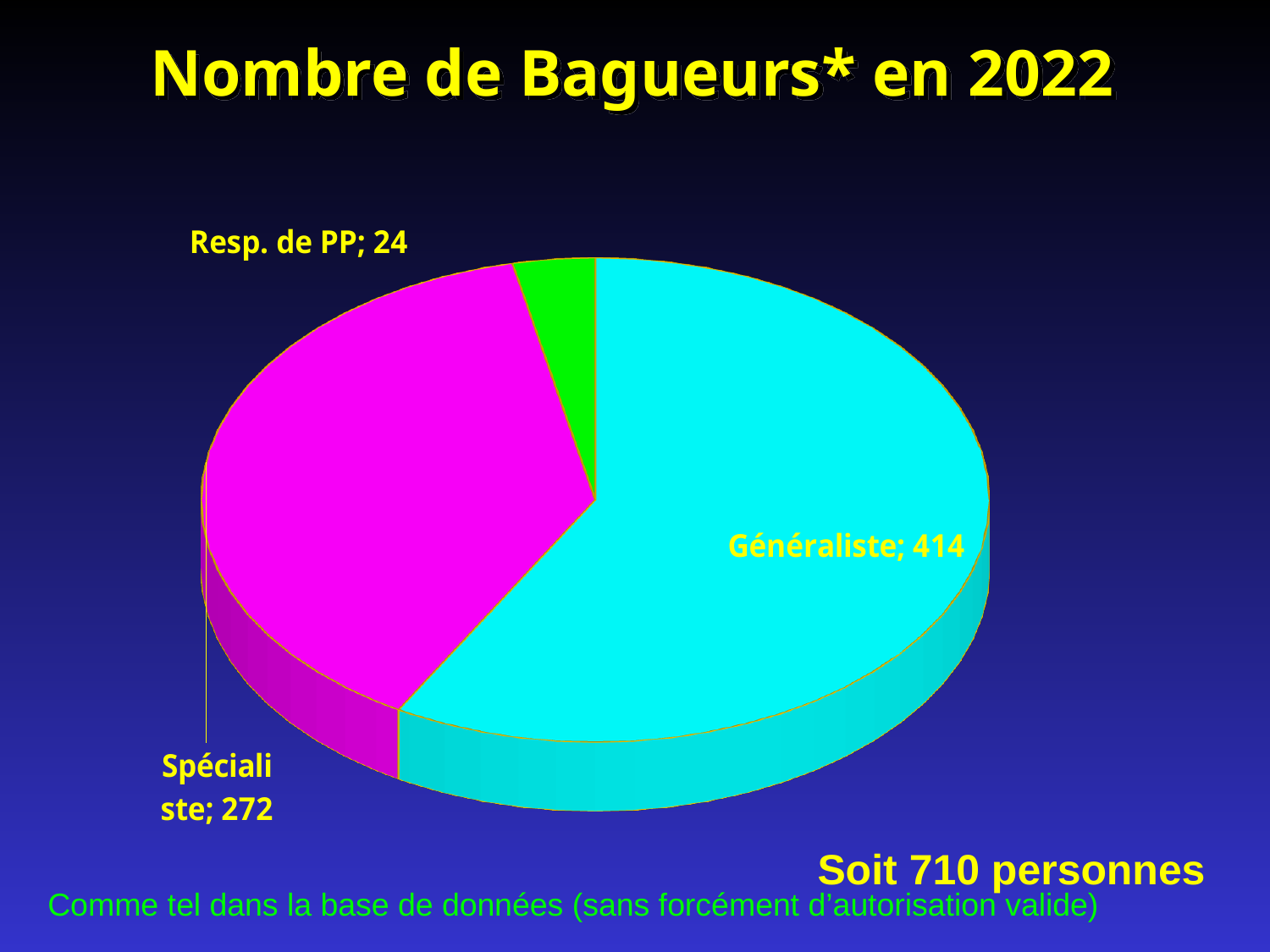
What colour is the Généraliste slice? Cyan Which category has the smallest slice? Resp. de PP What type of chart is shown on the slide? Pie chart What is the title of the chart? Nombre de Bagueurs* en 2022 How many slices does the pie chart have? 3 What is the value for Resp. de PP? 24 Which category has the largest slice? Généraliste What is the difference between the Généraliste and Spécialiste values? 142 What is the value for Généraliste? 414 Which is larger, Spécialiste or Resp. de PP? Spécialiste What is the value for Spécialiste? 272 What is the total of all slices in the pie chart? 710